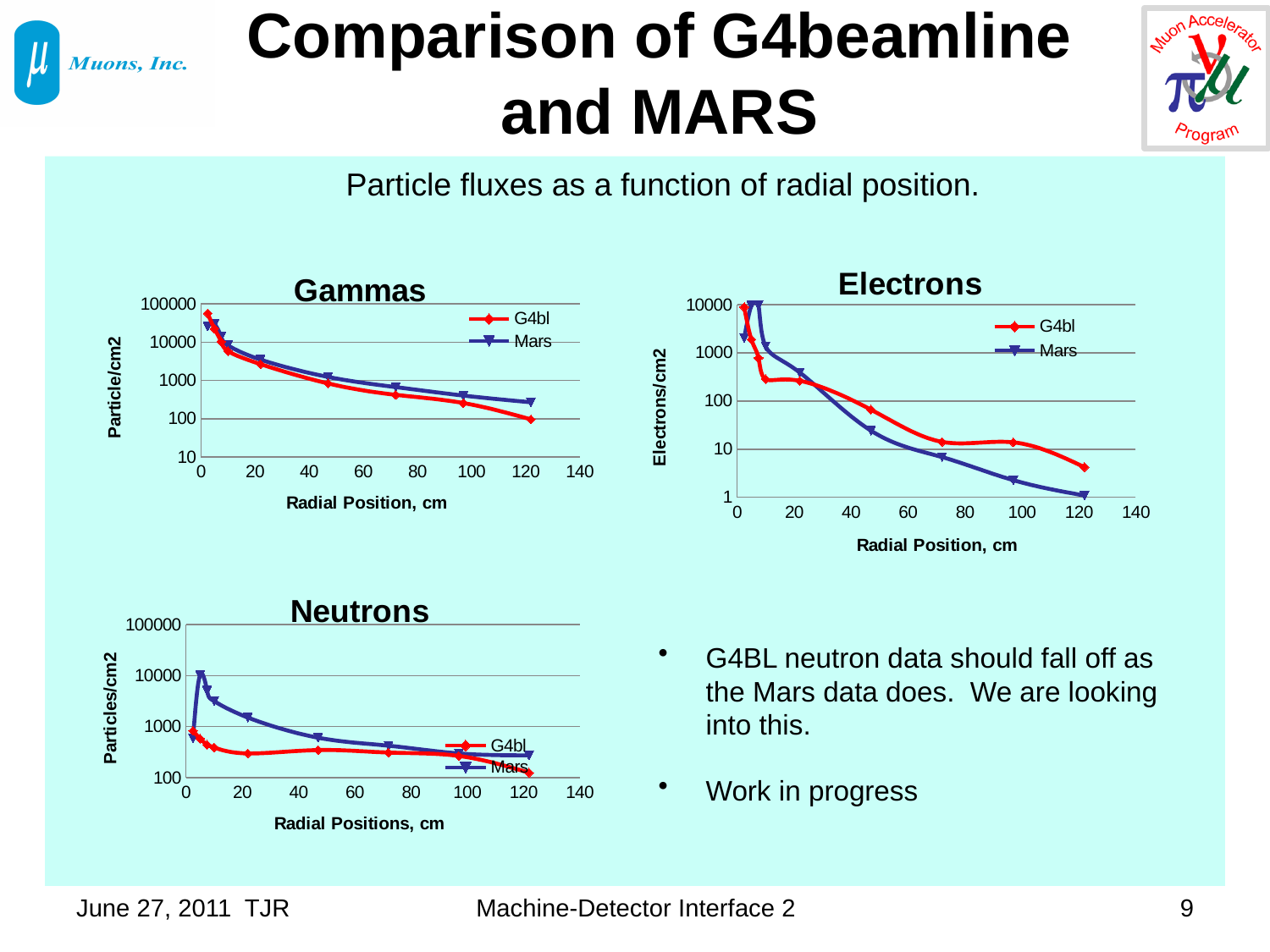
What kind of chart is the Gammas chart? line chart How many series does the legend of the Electrons chart list? 2 In the Electrons chart, which series has the larger value at about 120 cm, G4bl or Mars? G4bl In the Neutrons chart, is the peak Mars value greater or less than 1000? greater What is the y-axis label of the Electrons chart? Electrons/cm2 In the Gammas chart, is the Mars value at about 20 cm greater or less than 1000? greater In the Gammas chart, do the G4bl values rise or fall as radial position increases? fall How many charts are shown on the slide? 3 In the Electrons chart, is the Mars value at about 100 cm greater or less than 10? less In the Neutrons chart, which series has the larger value at about 20 cm, G4bl or Mars? Mars In the Neutrons chart, do the Mars values rise or fall as radial position increases beyond the peak? fall